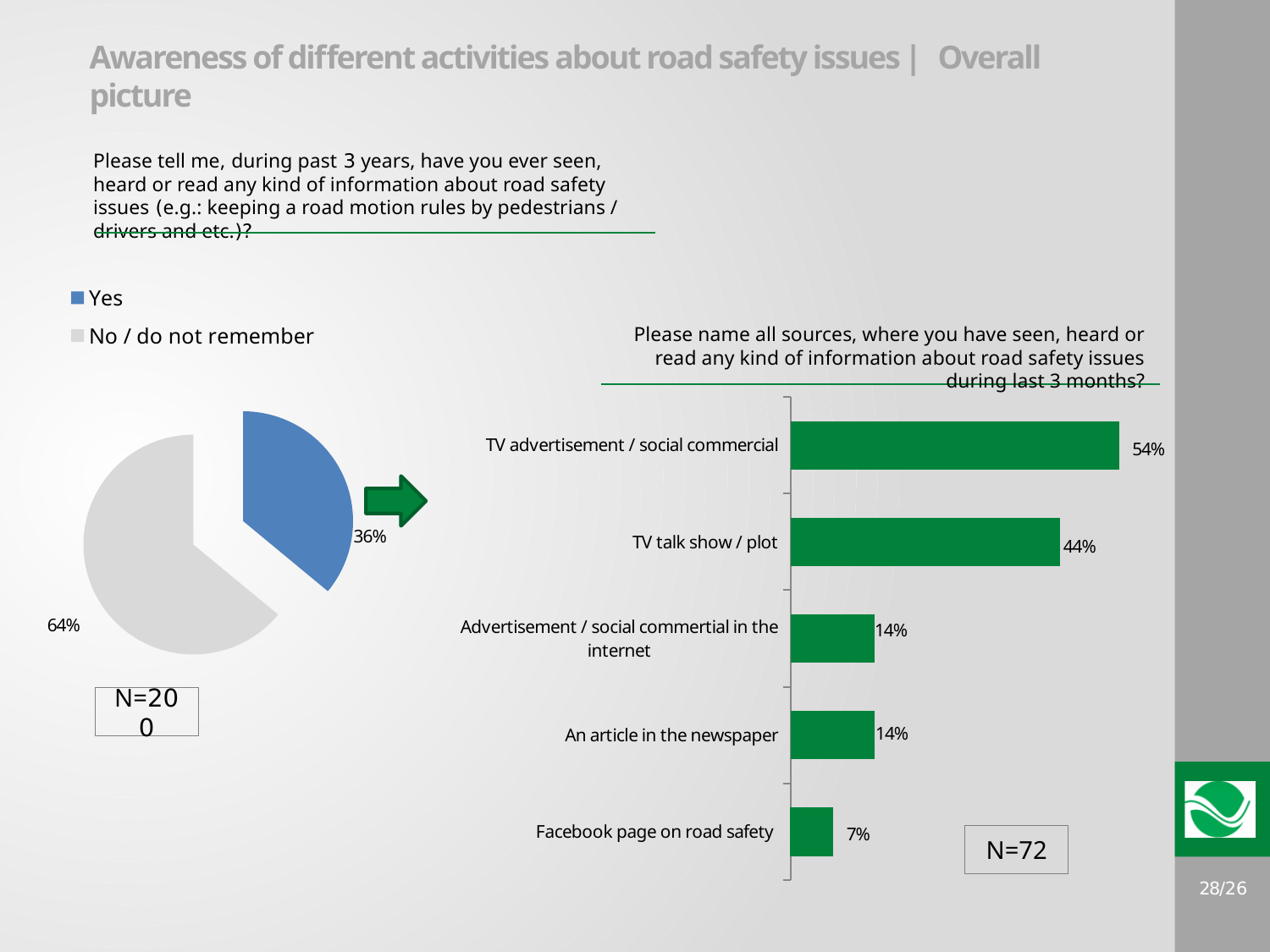
In the pie chart on the left, what share of respondents answered No / do not remember? 64% In the bar chart on the right, what is the value for TV talk show / plot? 44% In the bar chart on the right, which source has the lowest value? Facebook page on road safety In the bar chart on the right, what is the value for TV advertisement / social commercial? 54% In the bar chart on the right, what is the difference between TV advertisement / social commercial and TV talk show / plot? 10% In the bar chart on the right, which source has the highest value? TV advertisement / social commercial In the pie chart on the left, what share of respondents answered Yes? 36% In the pie chart on the left, how many entries does the legend list? 2 In the pie chart on the left, which answer has the larger share: Yes or No / do not remember? No / do not remember How many sources are listed in the bar chart on the right? 5 In the pie chart on the left, what is the difference between the No / do not remember share and the Yes share? 28% What kind of chart is shown on the right side of the slide? Bar chart